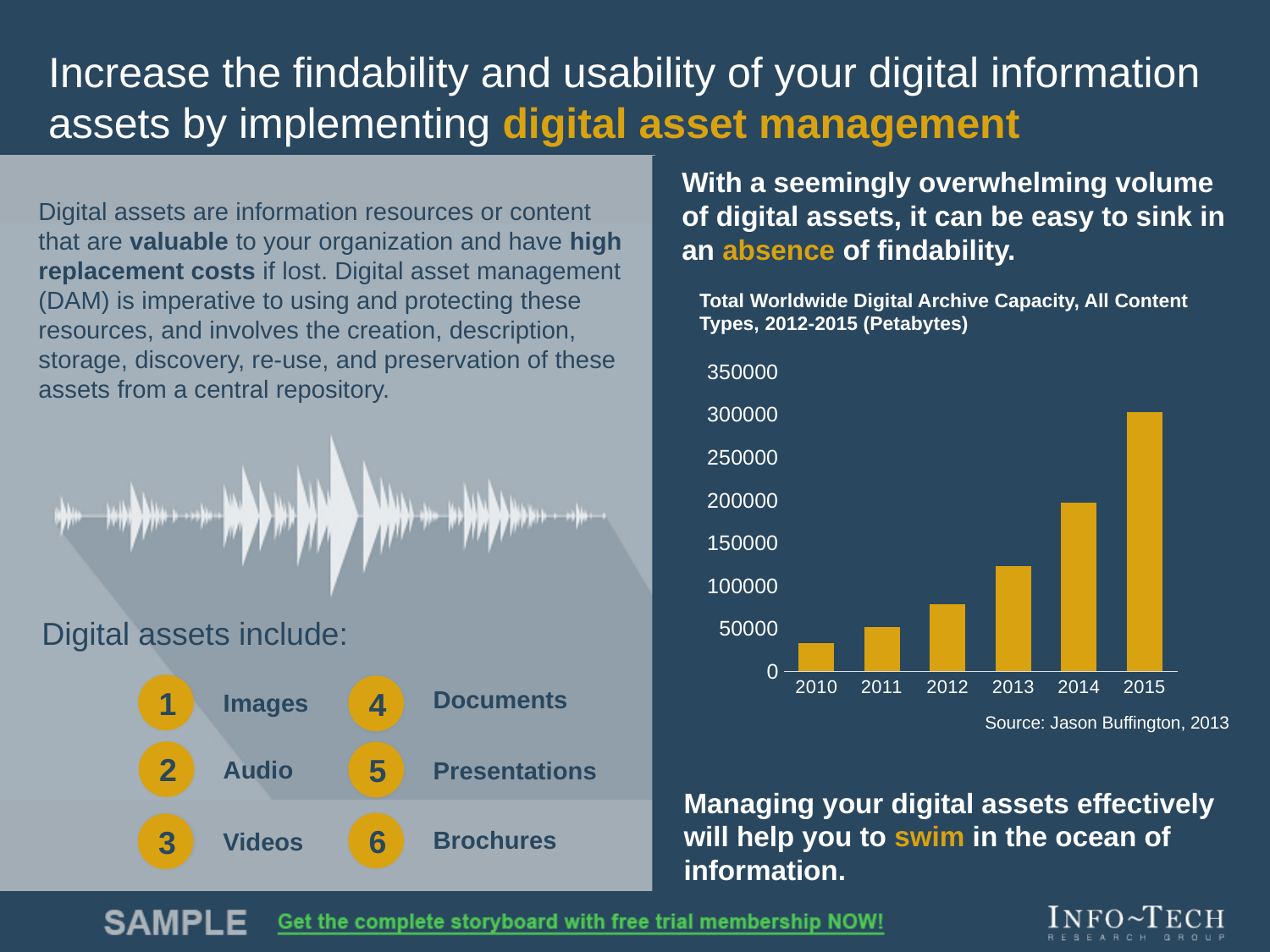
What source is cited below the chart? Jason Buffington, 2013 Which year has the lowest digital archive capacity in the chart? 2010 Do the values in the chart rise or fall from 2010 to 2015? rise Is the value for 2012 greater or less than 100000? less Which year has the highest digital archive capacity in the chart? 2015 Is the value for 2010 greater or less than 50000? less Is the value for 2014 greater or less than 150000? greater What kind of chart is shown on the slide? bar chart Which year has the larger value, 2013 or 2014? 2014 What is the title of the chart? Total Worldwide Digital Archive Capacity, All Content Types, 2012-2015 (Petabytes) How many years are plotted on the x axis of the chart? 6